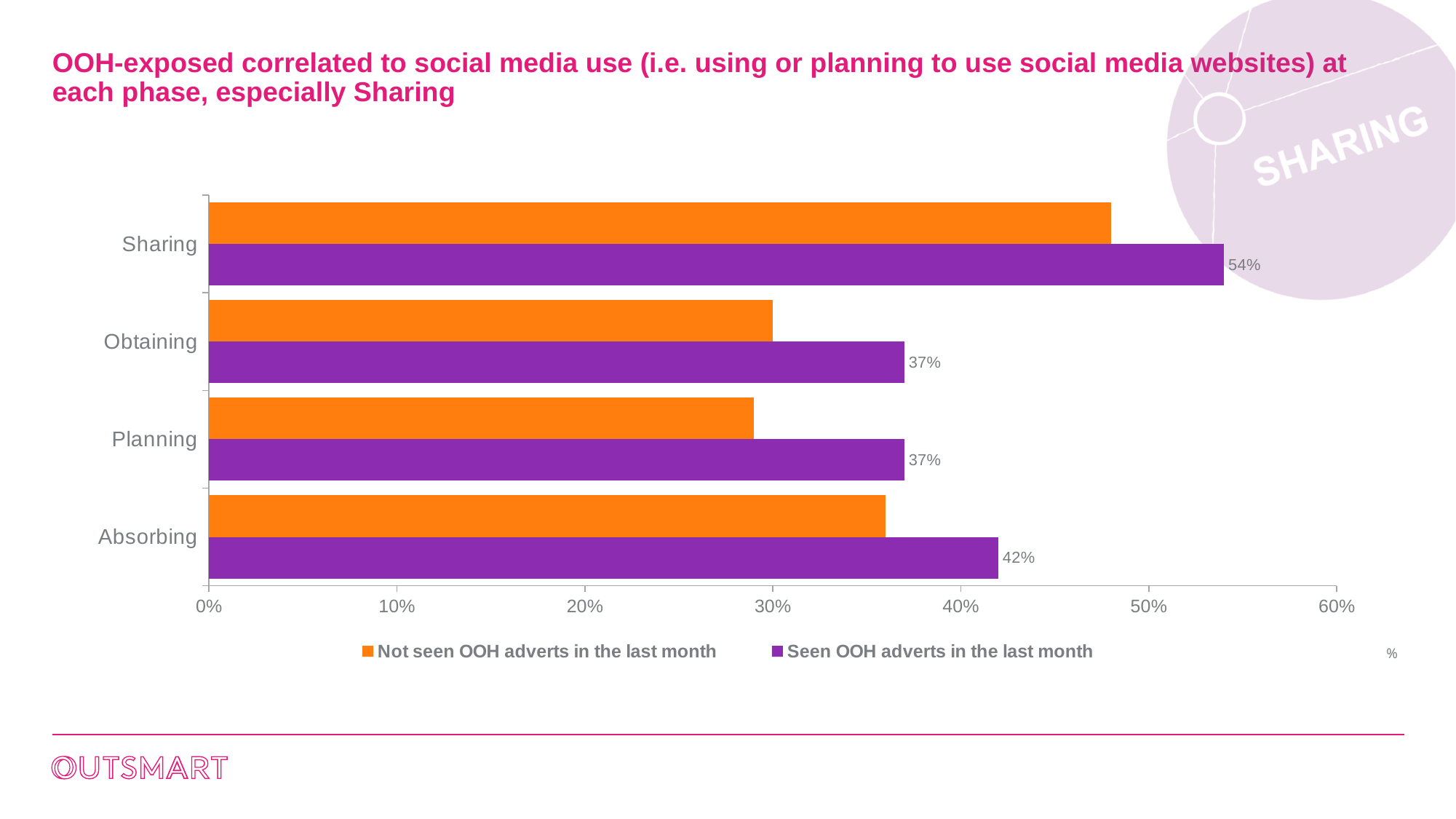
What is the value for Sharing in the 'Seen OOH adverts in the last month' series? 54% Is the value for Sharing in the 'Not seen OOH adverts in the last month' series greater or less than 40%? greater Which colour represents the 'Seen OOH adverts in the last month' series? purple How many phases (categories) are plotted on the chart? 4 What is the difference between the 'Seen OOH adverts in the last month' values for Sharing and Absorbing? 12% How many series does the legend list? 2 Which phase has the highest value in the 'Seen OOH adverts in the last month' series? Sharing What is the value for Absorbing in the 'Seen OOH adverts in the last month' series? 42% What is the value for Obtaining in the 'Seen OOH adverts in the last month' series? 37% What kind of chart is shown on the slide? bar chart For Sharing, which series has the larger value: 'Not seen OOH adverts in the last month' or 'Seen OOH adverts in the last month'? Seen OOH adverts in the last month Is the value for Planning in the 'Not seen OOH adverts in the last month' series greater or less than 40%? less